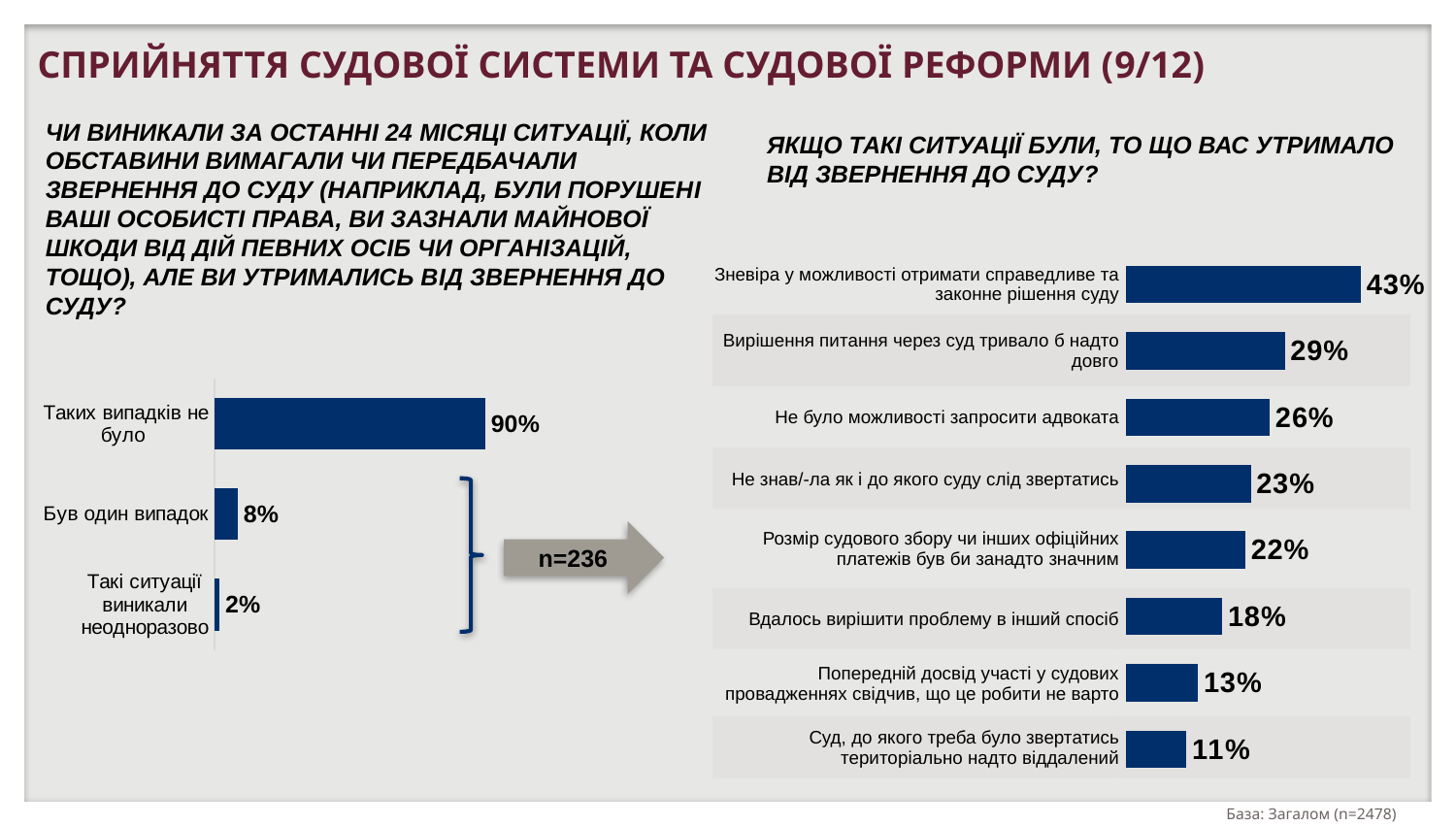
In the left chart, how many categories are shown? 3 In the right chart, what is the difference between "Зневіра у можливості отримати справедливе та законне рішення суду" and "Вирішення питання через суд тривало б надто довго"? 14% In the left chart, which category has the lowest value? Такі ситуації виникали неодноразово In the left chart, what is the value for "Був один випадок"? 8% In the left chart, what is the difference between "Був один випадок" and "Такі ситуації виникали неодноразово"? 6% In the right chart, how many categories are shown? 8 In the right chart, which category has the highest value? Зневіра у можливості отримати справедливе та законне рішення суду In the left chart, what is the value for "Таких випадків не було"? 90% In the right chart, what is the value for "Не було можливості запросити адвоката"? 26% In the right chart, which is larger: "Вдалось вирішити проблему в інший спосіб" or "Попередній досвід участі у судових провадженнях свідчив, що це робити не варто"? Вдалось вирішити проблему в інший спосіб What type of chart is the right chart? Bar chart In the right chart, which category has the lowest value? Суд, до якого треба було звертатись територіально надто віддалений